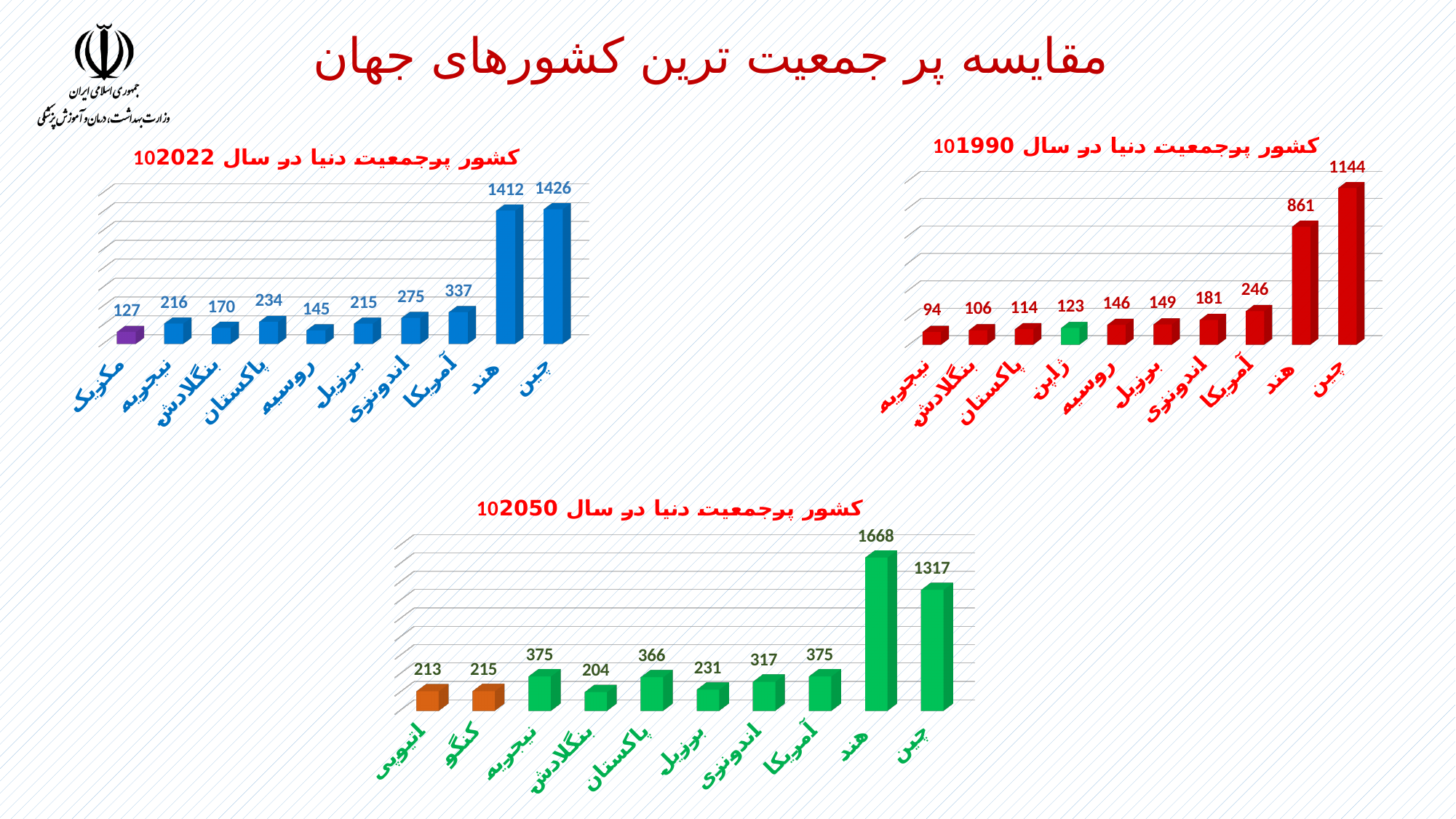
How many countries are shown in the 1990 chart (top right)? 10 In the 2050 chart (bottom), what is the value for پاکستان (Pakistan)? 366 What type of chart is the 2050 chart (bottom)? bar chart In the 1990 chart (top right), what is the value for آمریکا (USA)? 246 In the 2022 chart (top left), which is larger, the value for پاکستان (Pakistan) or the value for بنگلادش (Bangladesh)? پاکستان (Pakistan) In the 2022 chart (top left), what is the difference between the values for چین (China) and هند (India)? 14 In the 2022 chart (top left), what is the value for چین (China)? 1426 In the 2050 chart (bottom), which is larger, the value for اندونزی (Indonesia) or the value for برزیل (Brazil)? اندونزی (Indonesia) In the 1990 chart (top right), which country has the lowest value? نیجریه (Nigeria) In the 1990 chart (top right), what is the difference between the values for چین (China) and هند (India)? 283 How many charts are on the slide? 3 In the 2050 chart (bottom), which country has the highest value? هند (India)